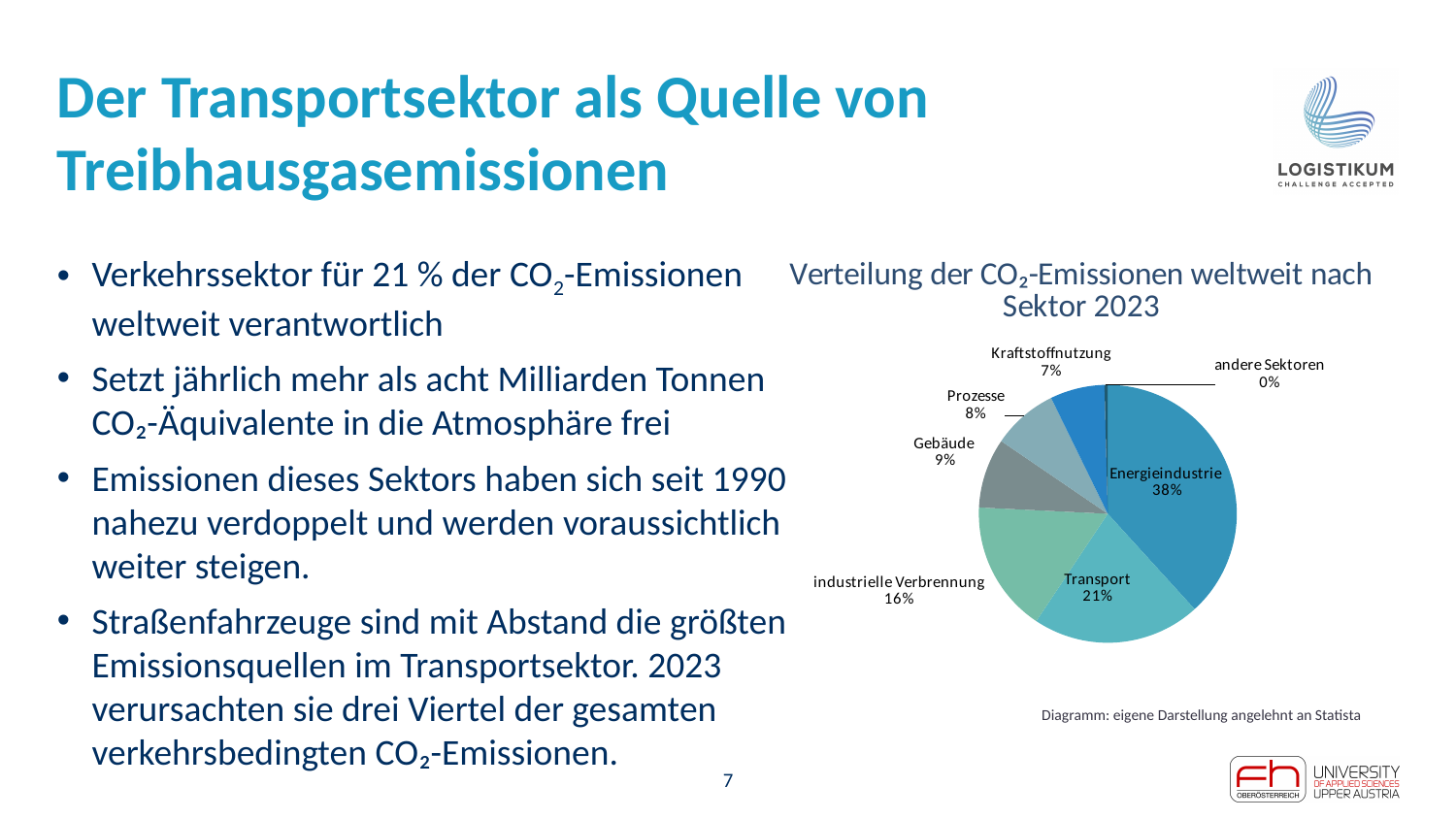
How many sectors are shown in the pie chart? 7 Which sector has the largest share of the pie? Energieindustrie What is the value shown for Kraftstoffnutzung? 7% Which sector has the smallest share of the pie? andere Sektoren What share of the pie does Energieindustrie have? 38% What kind of chart is shown on the slide? pie chart What is the value shown for Prozesse? 8% What is the title of the pie chart? Verteilung der CO₂-Emissionen weltweit nach Sektor 2023 What is the value shown for Gebäude? 9% What share of the pie does Transport have? 21% What is the value shown for industrielle Verbrennung? 16% What is the difference in percentage points between Energieindustrie and Transport? 17